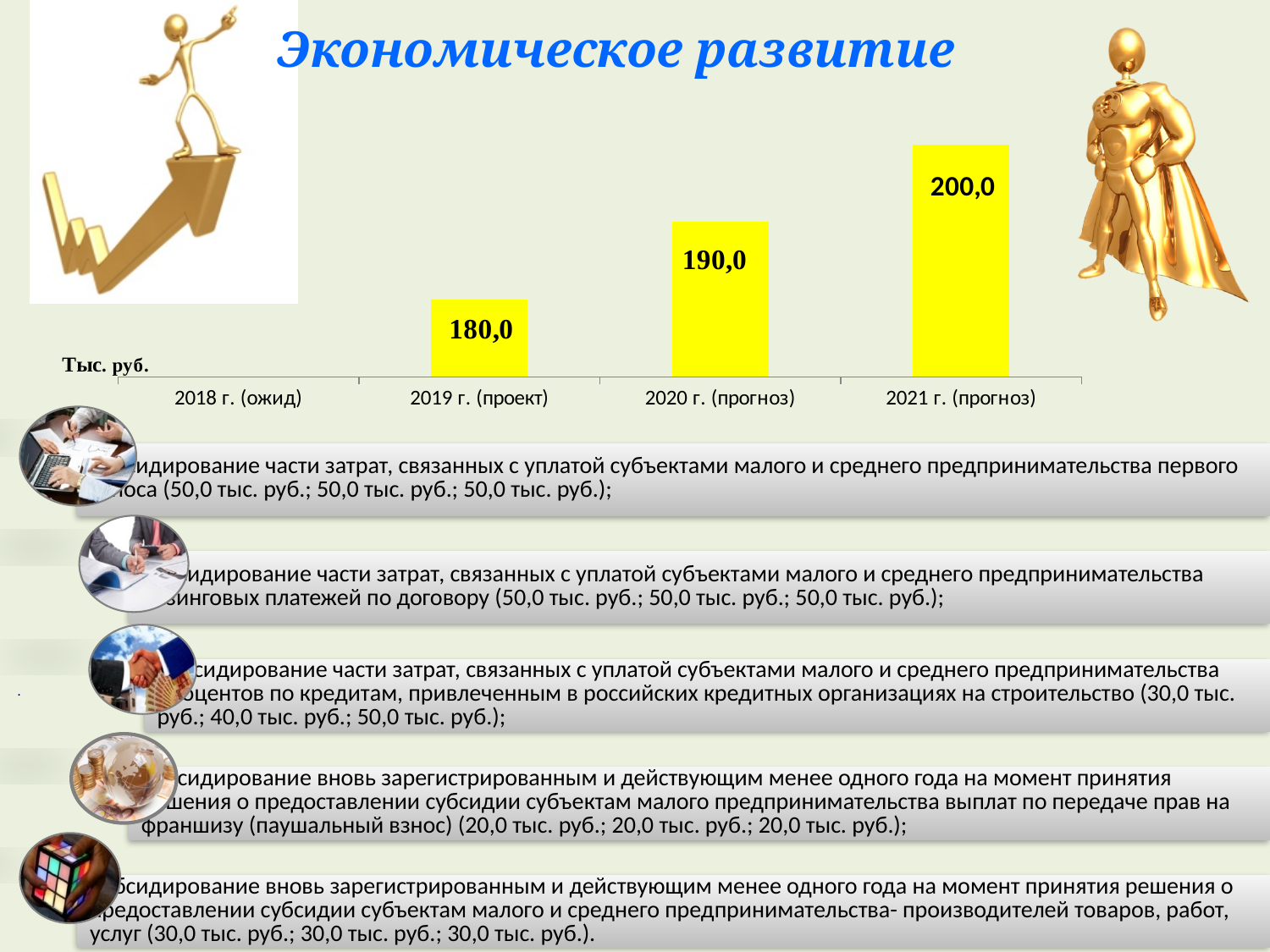
What is the value for 2021 г. (прогноз)? 200,0 What is the value for 2020 г. (прогноз)? 190,0 Do the values rise or fall from 2019 г. (проект) to 2021 г. (прогноз)? rise Which is larger, the value for 2020 г. (прогноз) or 2019 г. (проект)? 2020 г. (прогноз) Which category has the highest value? 2021 г. (прогноз) What unit is indicated for the chart values? Тыс. руб. How many categories are shown on the x axis? 4 What is the difference between the values for 2021 г. (прогноз) and 2019 г. (проект)? 20,0 What kind of chart is shown on the slide? bar chart What is the difference between the values for 2020 г. (прогноз) and 2019 г. (проект)? 10,0 Which of the labelled bars has the lowest value? 2019 г. (проект) What is the value for 2019 г. (проект)? 180,0